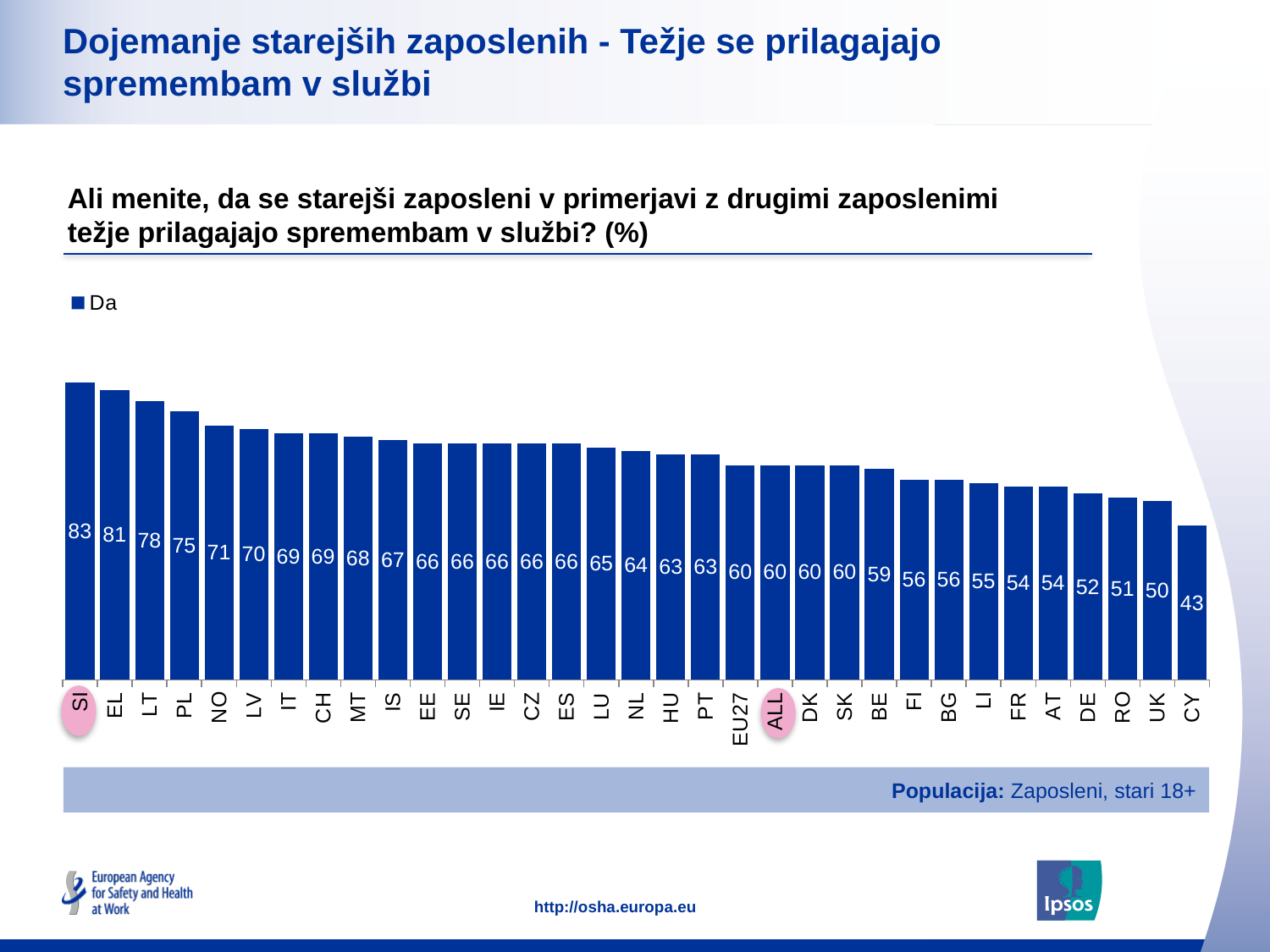
Which category has the highest value? SI What is the difference between the values for EL and UK? 31 What is the value for PL? 75 What is the value for EU27? 60 Which category has the lowest value? CY What is the difference between the values for SI and CY? 40 What kind of chart is shown on the slide? Bar chart What is the value for CY? 43 Which is larger, the value for NO or the value for DE? NO What is the value for SI? 83 How many categories are shown on the x axis? 33 How many series does the legend list? 1